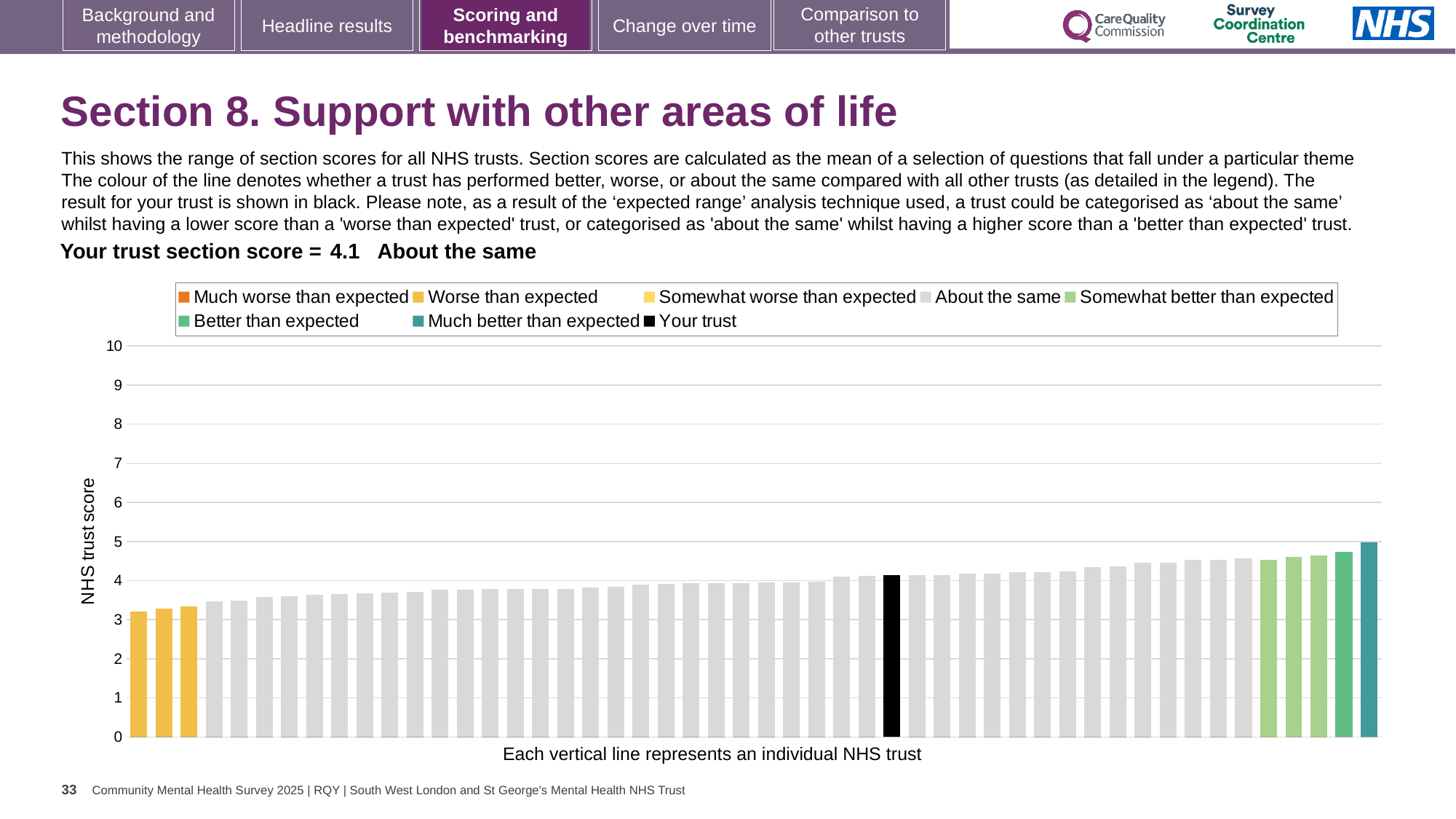
How many entries does the chart legend list? 8 What is the label on the y axis of the chart? NHS trust score Is the value of the highest bar on the chart greater or less than 6? less Is the value of the lowest bar on the chart greater or less than 4? less Do the bar values rise or fall from left to right along the x axis? rise What is the section score for your trust (the black bar)? 4.1 Which legend category does the lowest bar on the chart belong to? Worse than expected What kind of chart is shown on the slide? bar chart How many bars are coloured as 'Much better than expected'? 1 Which legend category does the highest bar on the chart belong to? Much better than expected How many bars are coloured as 'Worse than expected'? 3 Is the value of the black 'Your trust' bar greater or less than 4? greater